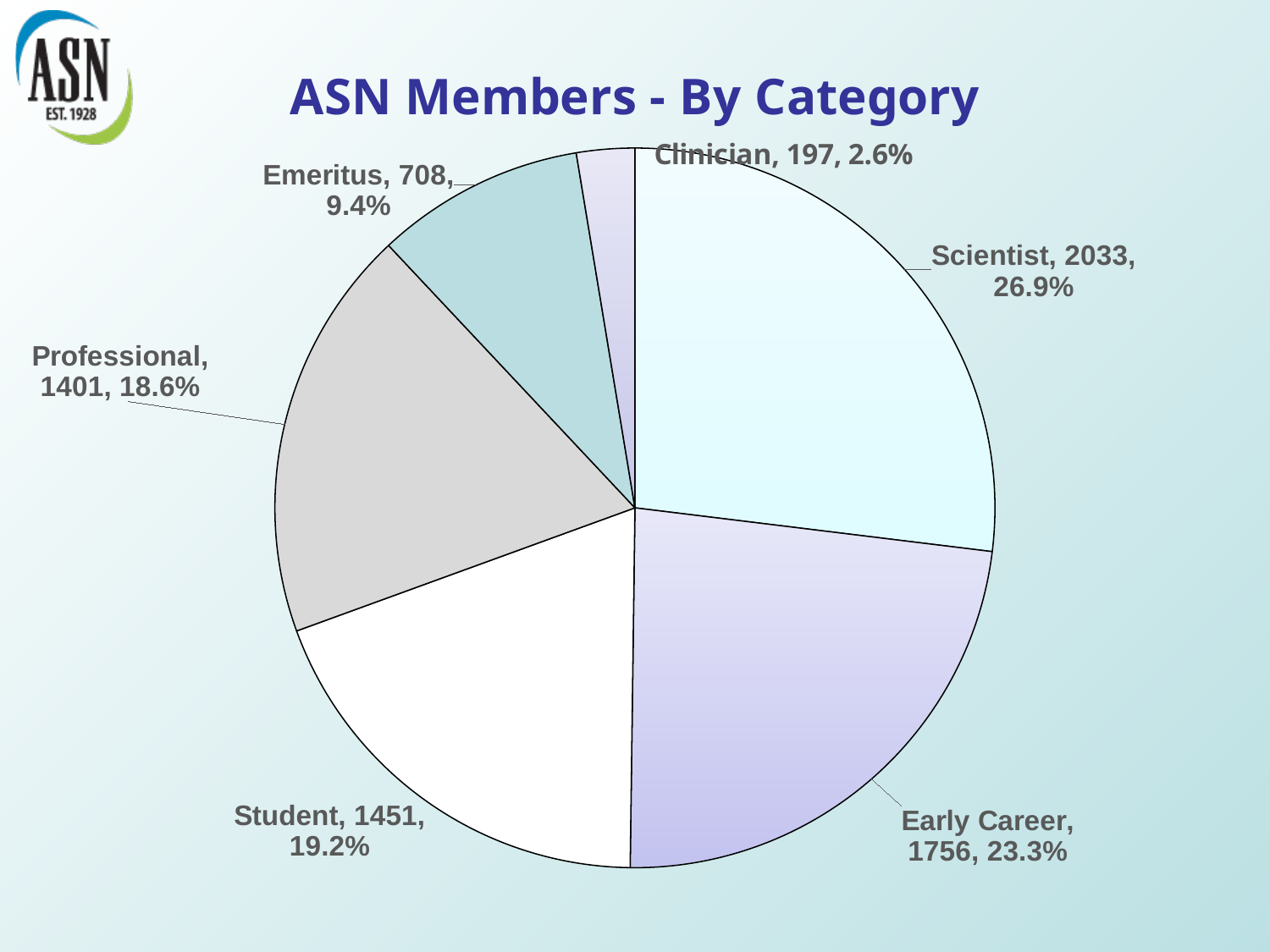
Which category has the largest number of members? Scientist Which category has the smallest number of members? Clinician How many members are in the Scientist category? 2033 What is the difference in members between Early Career and Professional? 355 What is the title of the chart? ASN Members - By Category What percentage share does the Clinician category have? 2.6% How many members are in the Emeritus category? 708 What percentage share does the Student category have? 19.2% Which category has more members, Student or Professional? Student What kind of chart is shown on the slide? pie chart How many categories are shown in the pie chart? 6 What is the difference in members between Scientist and Early Career? 277